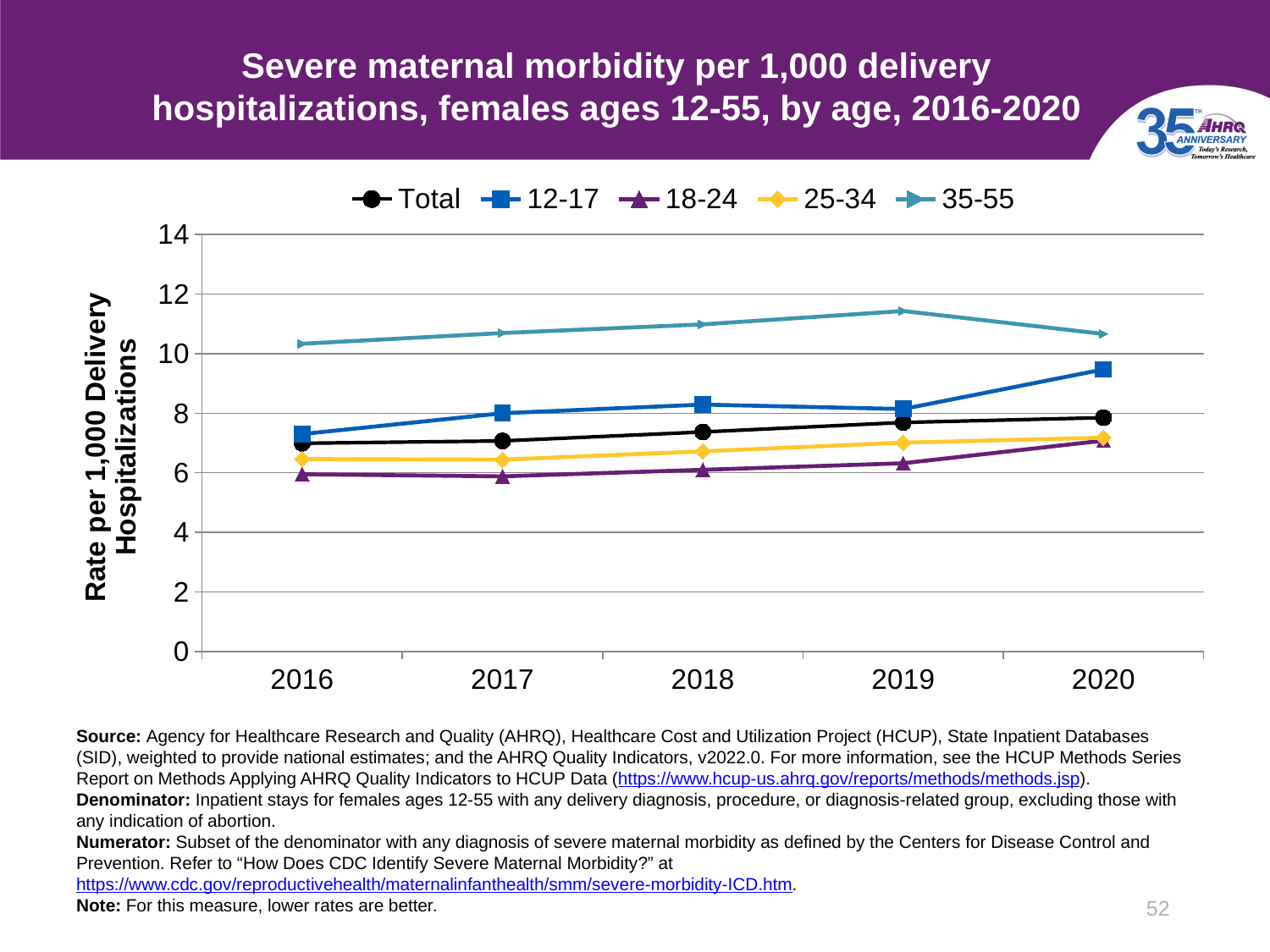
Is the value for the 18-24 group in 2017 greater or less than 8? less In which year does the 35-55 group reach its highest rate? 2019 What kind of chart is shown on the slide? Line chart Is the value for the 12-17 group in 2020 greater or less than 8? greater How many years are plotted along the x axis? 5 What is the label on the y axis? Rate per 1,000 Delivery Hospitalizations How many series does the legend list? 5 Is the value for the 35-55 group in 2019 greater or less than 10? greater Which age group has the highest rate in 2020? 35-55 Which age group has the lowest rate in 2016? 18-24 Does the Total rate rise or fall from 2016 to 2020? Rise In 2020, which is larger: the rate for the 12-17 group or the Total rate? 12-17